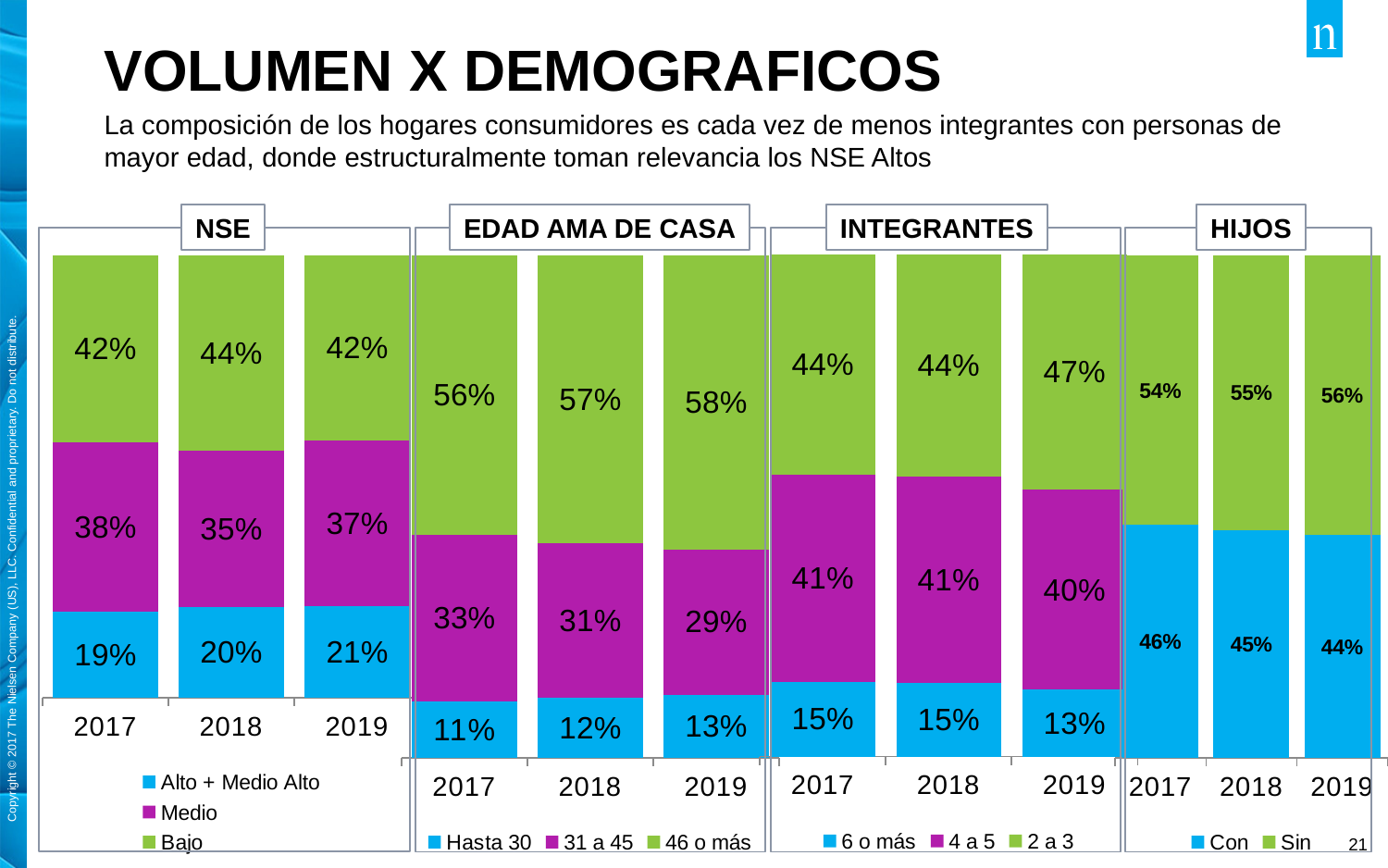
In the HIJOS chart, what is the value for Con in 2018? 45% In the EDAD AMA DE CASA chart, does the value for 31 a 45 rise or fall from 2017 to 2019? fall In the INTEGRANTES chart, what is the value for 2 a 3 in 2019? 47% How many series does the legend of the EDAD AMA DE CASA chart list? 3 In the NSE chart, what is the value for Alto + Medio Alto in 2019? 21% In the HIJOS chart, which is larger in 2019, Con or Sin? Sin In the EDAD AMA DE CASA chart, what is the value for 46 o más in 2019? 58% In the NSE chart, which year has the highest value for Bajo? 2018 In the NSE chart, what is the value for Medio in 2018? 35% What kind of chart is the NSE chart? stacked bar chart In the INTEGRANTES chart, what is the difference between the 4 a 5 value in 2017 and the 6 o más value in 2017? 26% In the HIJOS chart, does the value for Sin rise or fall from 2017 to 2019? rise